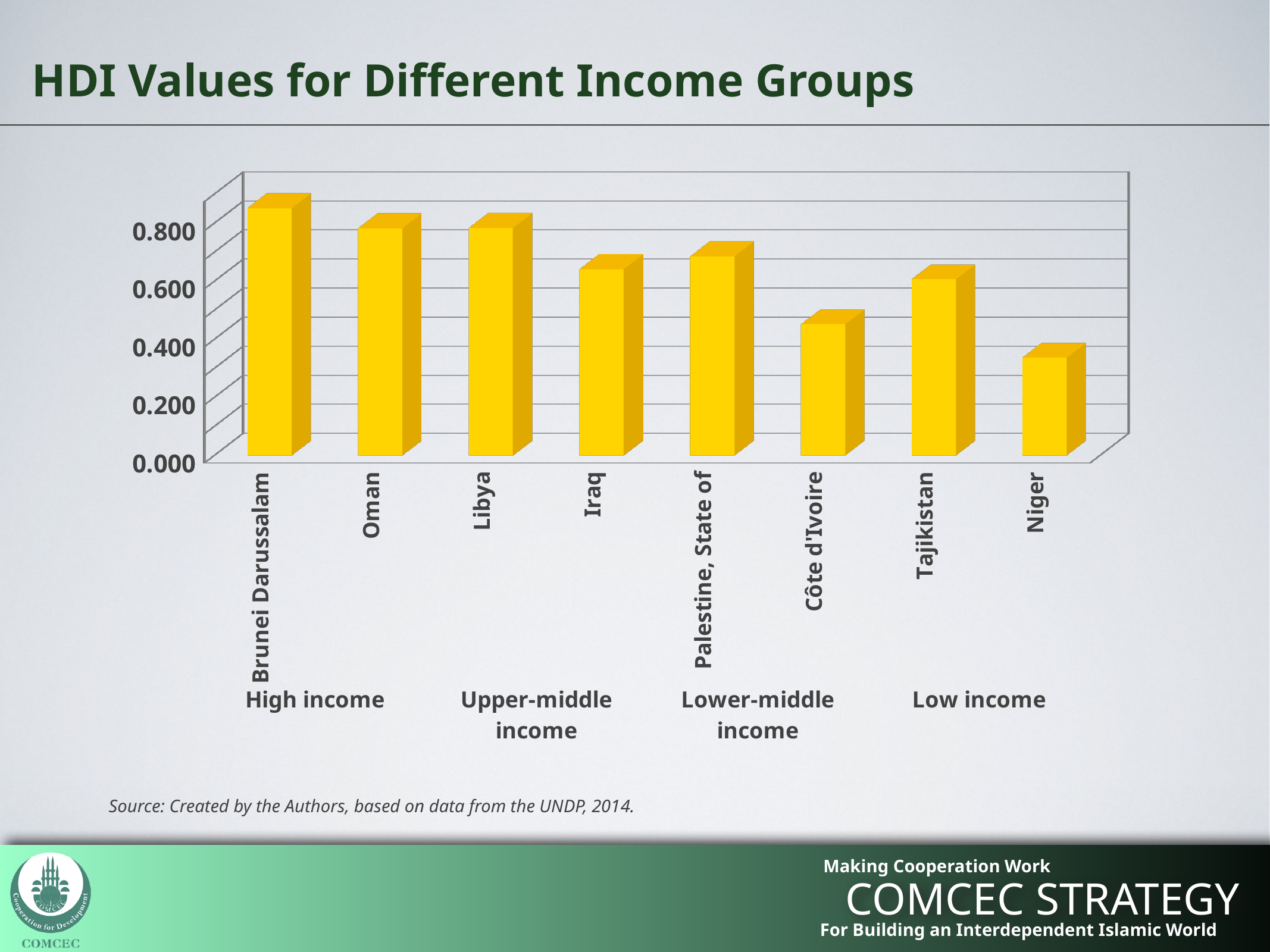
What kind of chart is shown on the slide? Bar chart Is the HDI value for Côte d'Ivoire greater or less than 0.600? less How many countries are plotted in the chart? 8 Is the HDI value for Brunei Darussalam greater or less than 0.800? greater Which has a higher HDI value, Palestine, State of or Iraq? Palestine, State of Which has a higher HDI value, Tajikistan or Côte d'Ivoire? Tajikistan What is the title of the chart? HDI Values for Different Income Groups Is the HDI value for Niger greater or less than 0.400? less Which country has the highest HDI value in the chart? Brunei Darussalam How many income groups are labelled along the bottom of the chart? 4 Which country has the lowest HDI value in the chart? Niger